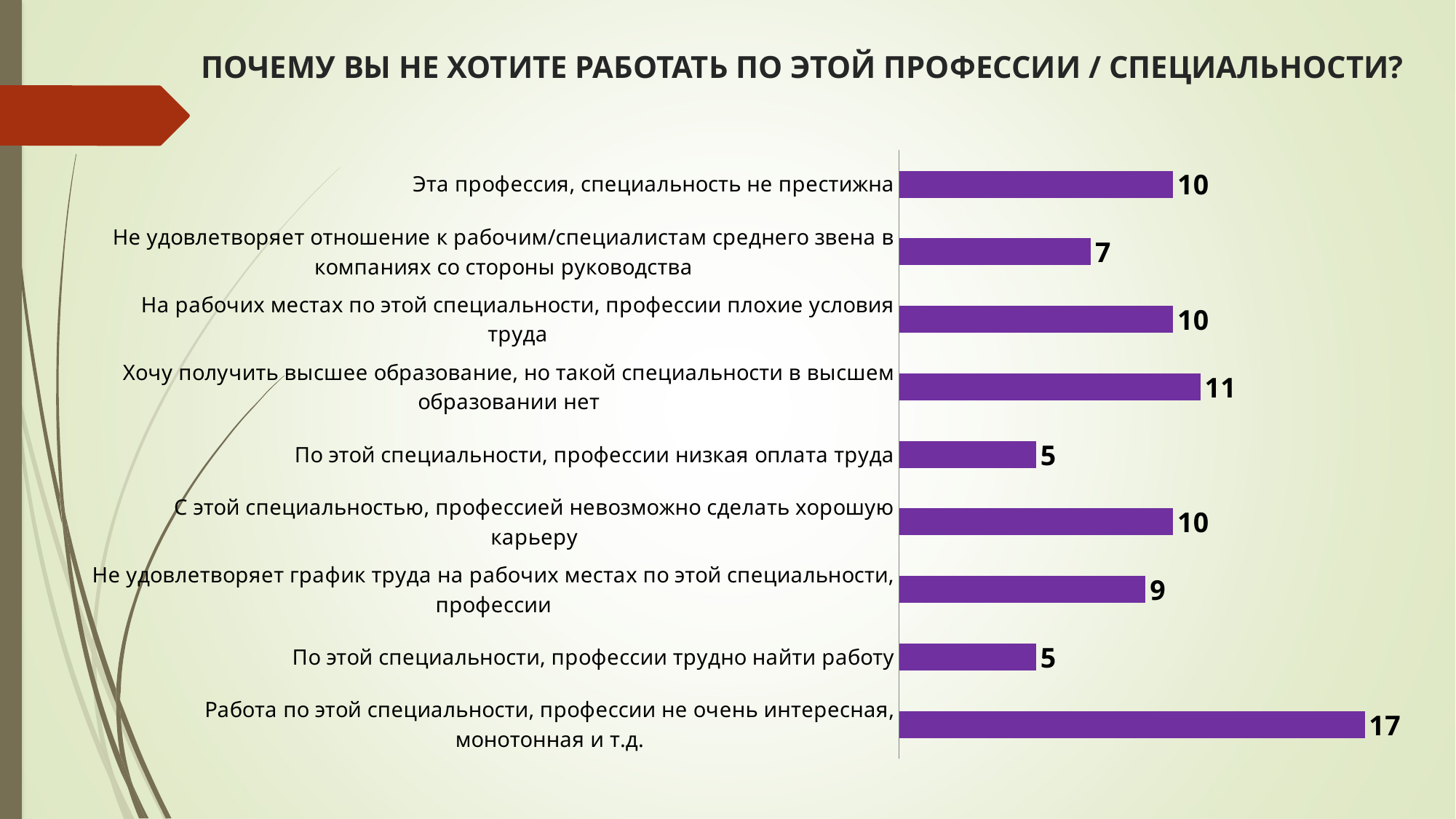
How many categories (reasons) are plotted in the chart? 9 What is the value for "Эта профессия, специальность не престижна"? 10 What is the value for "Не удовлетворяет отношение к рабочим/специалистам среднего звена в компаниях со стороны руководства"? 7 What is the value for "Не удовлетворяет график труда на рабочих местах по этой специальности, профессии"? 9 What is the difference between the value for "Работа по этой специальности, профессии не очень интересная, монотонная и т.д." and the value for "По этой специальности, профессии трудно найти работу"? 12 What kind of chart is shown on the slide? bar chart What is the difference between the value for "Хочу получить высшее образование, но такой специальности в высшем образовании нет" and the value for "Не удовлетворяет отношение к рабочим/специалистам среднего звена в компаниях со стороны руководства"? 4 What is the smallest value shown in the chart? 5 What is the value for "Хочу получить высшее образование, но такой специальности в высшем образовании нет"? 11 What is the title of the slide above the chart? ПОЧЕМУ ВЫ НЕ ХОТИТЕ РАБОТАТЬ ПО ЭТОЙ ПРОФЕССИИ / СПЕЦИАЛЬНОСТИ? Which is larger: the value for "Не удовлетворяет график труда на рабочих местах по этой специальности, профессии" or the value for "По этой специальности, профессии низкая оплата труда"? Не удовлетворяет график труда на рабочих местах по этой специальности, профессии Which category has the highest value? Работа по этой специальности, профессии не очень интересная, монотонная и т.д.